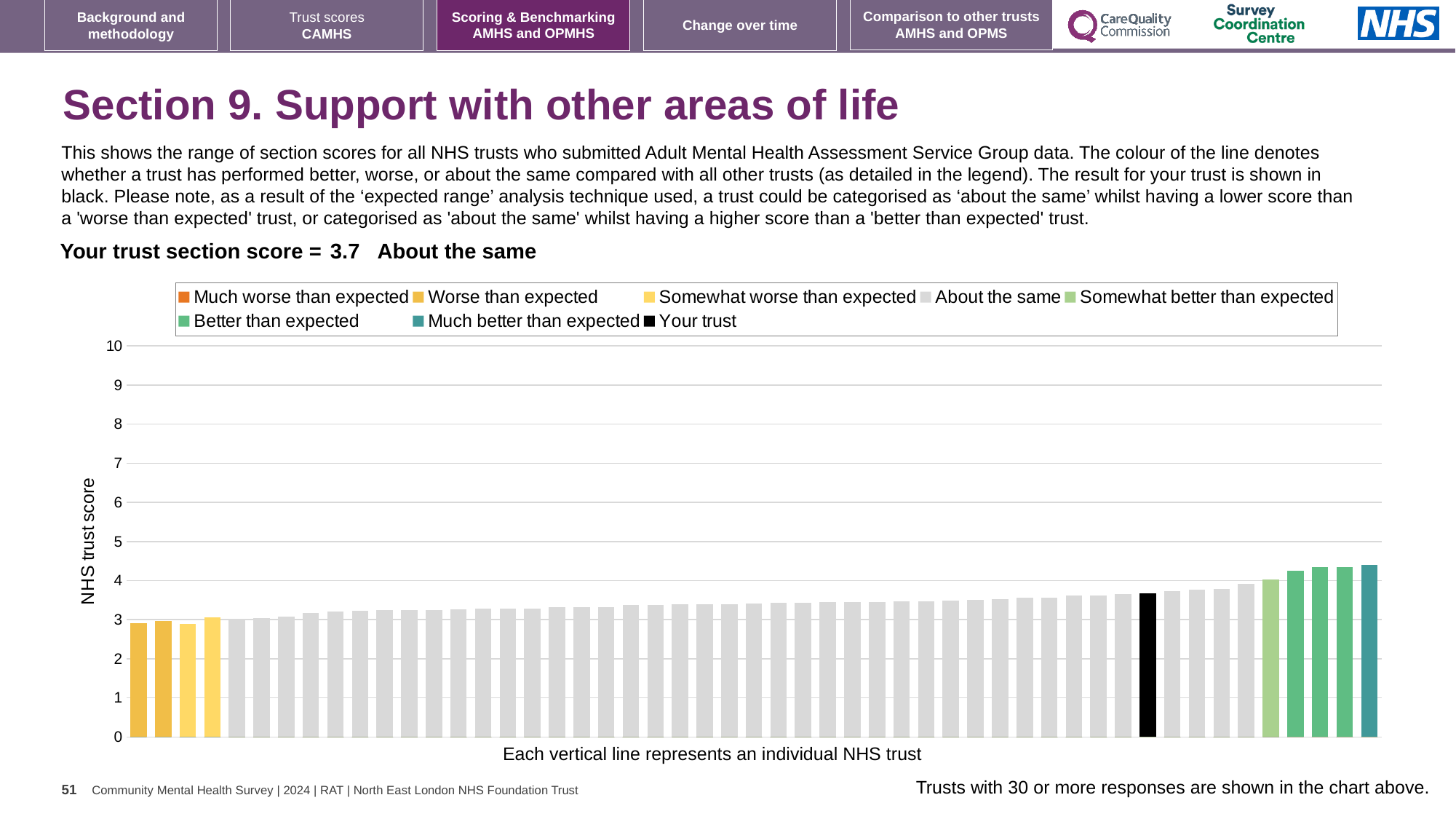
Is the value of the tallest bar in the chart greater or less than 4? greater How many bars are coloured as 'Much better than expected' (teal)? 1 Is the value for your trust (the black bar) greater or less than 4? less What is the label on the vertical axis of the chart? NHS trust score Do the bar values rise or fall from left to right along the x axis? Rise How many bars are coloured as 'Better than expected' (green)? 3 How many entries does the chart legend list? 8 What colour is used for 'Your trust' in the chart legend? Black What kind of chart is shown on the slide? Bar chart Which is larger: the value of the rightmost bar or the value of your trust's black bar? The rightmost bar What is the section score for your trust shown on the slide? 3.7 Is the value for your trust (the black bar) greater or less than 3? greater